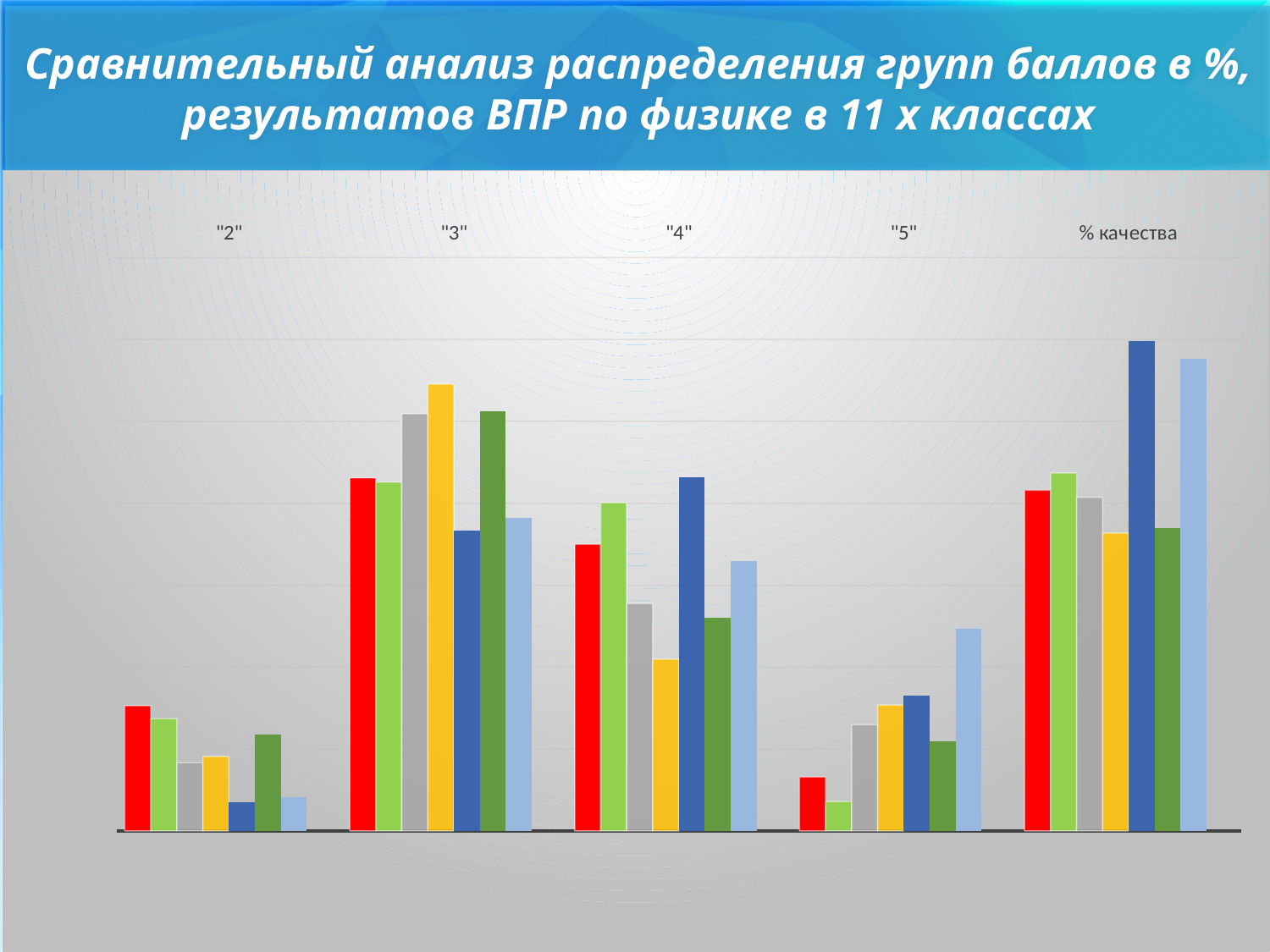
How many bars are plotted in each category group of the chart? 7 Is the red bar larger in the "2" category or in the "3" category? "3" In the "4" category, which coloured bar is the shortest? yellow In the "5" category, which coloured bar is the tallest? light blue How many categories are shown along the x axis of the chart? 5 In the "2" category, which coloured bar is the tallest? red What is the label of the last category on the x axis? % качества In the "3" category, which coloured bar is the tallest? yellow What kind of chart is shown on the slide? bar chart In the "2" category, which coloured bar is the shortest? dark blue Is the dark blue bar larger in the "4" category or in the "5" category? "4"